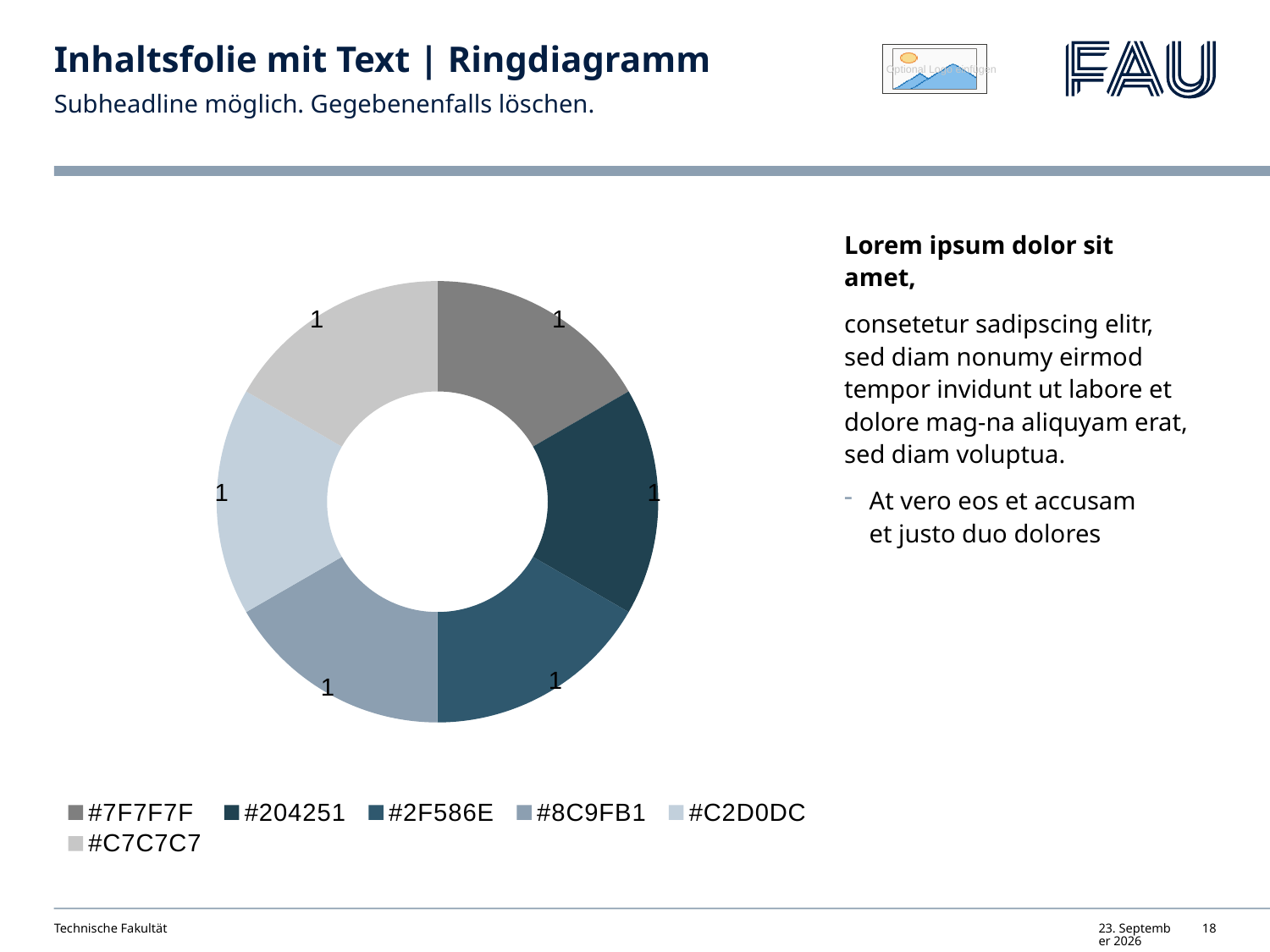
What is the value of the #2F586E slice? 1 What is the value of the #7F7F7F slice? 1 How many entries does the legend of the doughnut chart list? 6 What is the total of all slice values in the doughnut chart? 6 What is the difference between the values of the #204251 slice and the #C7C7C7 slice? 0 What is the value of the #C2D0DC slice? 1 What is the value of the #204251 slice? 1 What kind of chart is shown on the slide? doughnut chart What is the value of the #8C9FB1 slice? 1 What is the first entry listed in the chart legend? #7F7F7F How many slices does the doughnut chart have? 6 What is the value of the #C7C7C7 slice? 1